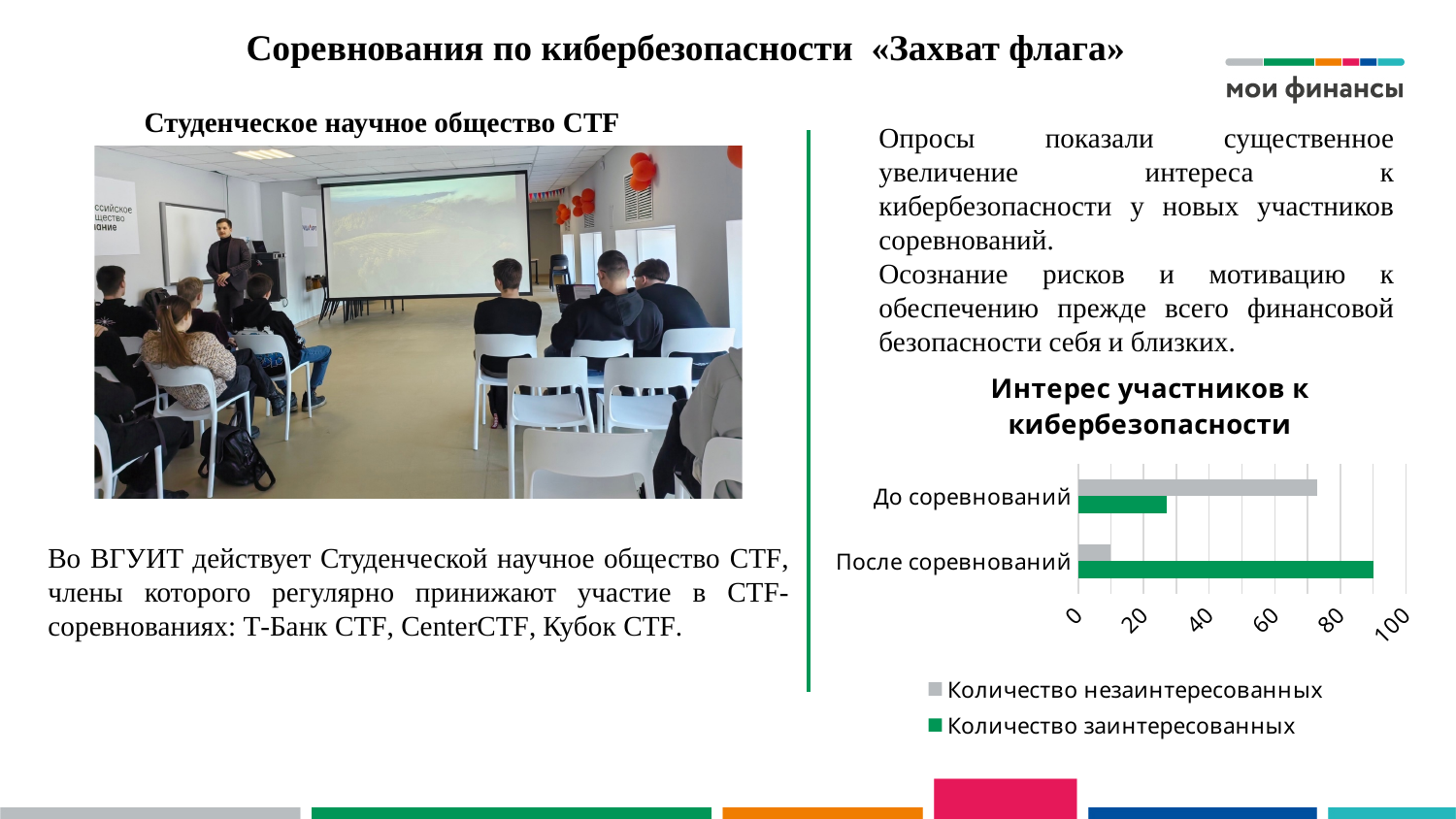
Which series is shown in green in the chart? Количество заинтересованных Is the value of Количество заинтересованных for После соревнований greater or less than 80? greater Does Количество заинтересованных rise or fall from До соревнований to После соревнований? rise Is the value of Количество незаинтересованных for До соревнований greater or less than 60? greater How many categories are shown on the chart's vertical axis? 2 What type of chart is shown on the slide? bar chart Is the value of Количество заинтересованных for До соревнований greater or less than 40? less What is the title of the chart on the slide? Интерес участников к кибербезопасности How many series does the chart legend list? 2 For which category is Количество заинтересованных highest? После соревнований For До соревнований, which series has the larger value: Количество незаинтересованных or Количество заинтересованных? Количество незаинтересованных